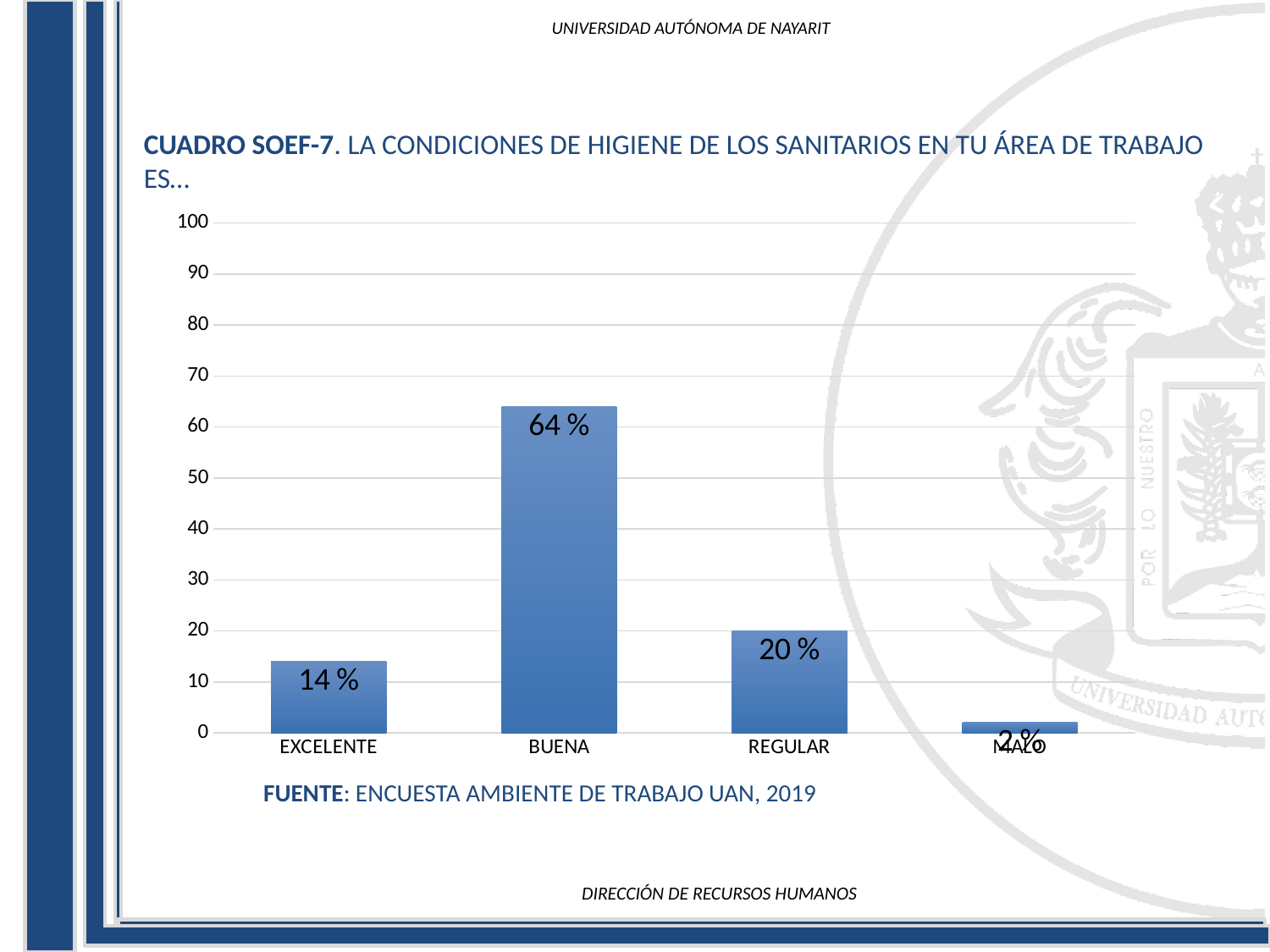
Is the value for BUENA greater or less than 50? greater How many categories are shown on the x axis? 4 What source is cited below the chart? ENCUESTA AMBIENTE DE TRABAJO UAN, 2019 Which is larger, the value for REGULAR or the value for EXCELENTE? REGULAR Which category has the highest value? BUENA What kind of chart is shown on the slide? bar chart Which category has the lowest value? MALO What is the difference between the values for BUENA and REGULAR? 44 % What is the value for MALO? 2 % What is the value for BUENA? 64 % What is the value for EXCELENTE? 14 % What is the value for REGULAR? 20 %